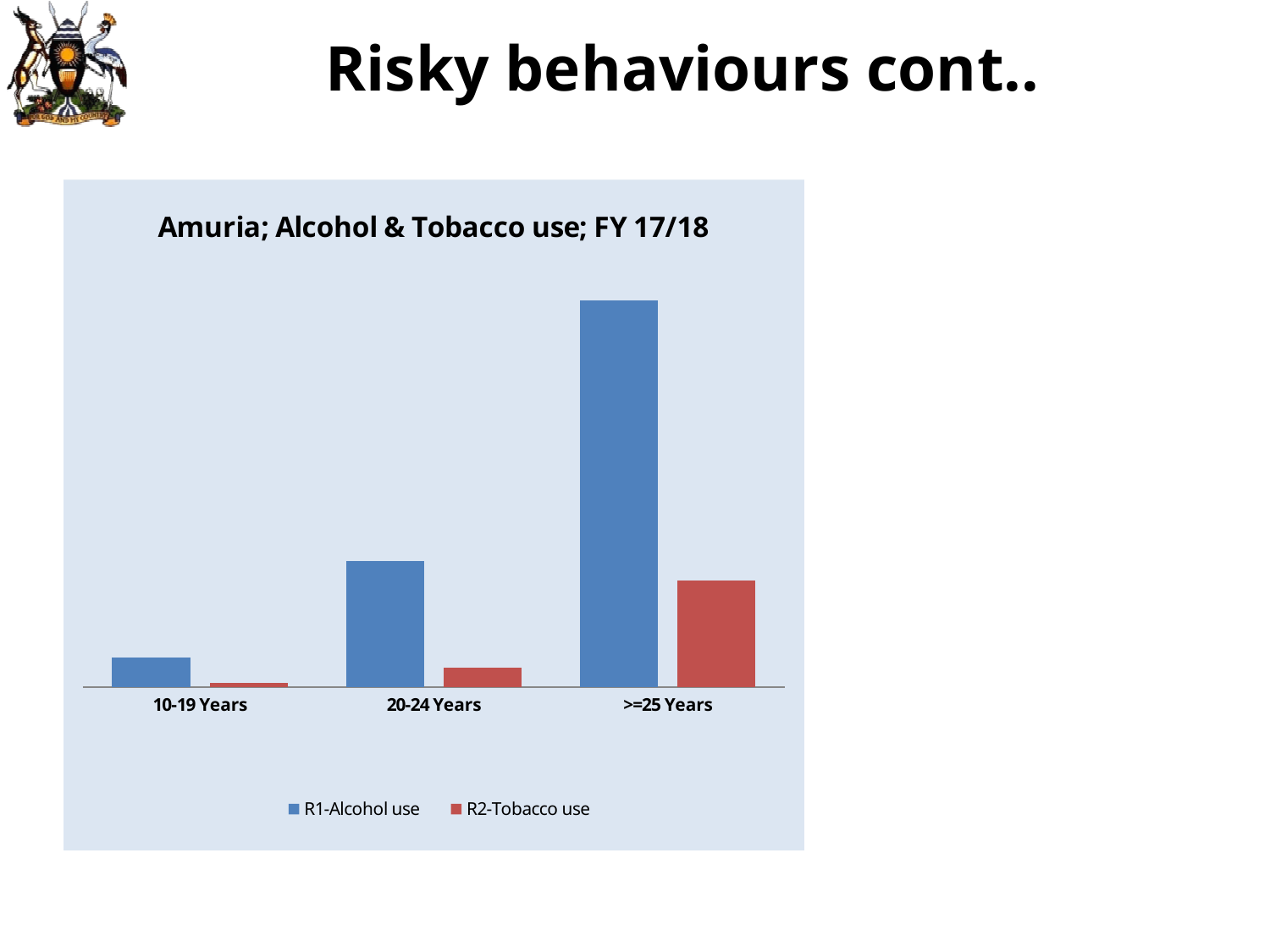
How many age-group categories are shown on the x axis? 3 Which colour represents R2-Tobacco use in the legend? Red Which age group has the lowest value for R1-Alcohol use? 10-19 Years How many series does the legend list? 2 Which is larger: R1-Alcohol use for 20-24 Years or R2-Tobacco use for >=25 Years? R1-Alcohol use for 20-24 Years Which age group has the highest value for R2-Tobacco use? >=25 Years What is the title of the chart? Amuria; Alcohol & Tobacco use; FY 17/18 Do the R1-Alcohol use values rise or fall as the age groups move from 10-19 Years to >=25 Years? Rise Which age group has the highest value for R1-Alcohol use? >=25 Years What kind of chart is shown on the slide? Bar chart For the >=25 Years group, which is larger: R1-Alcohol use or R2-Tobacco use? R1-Alcohol use Which age group has the lowest value for R2-Tobacco use? 10-19 Years